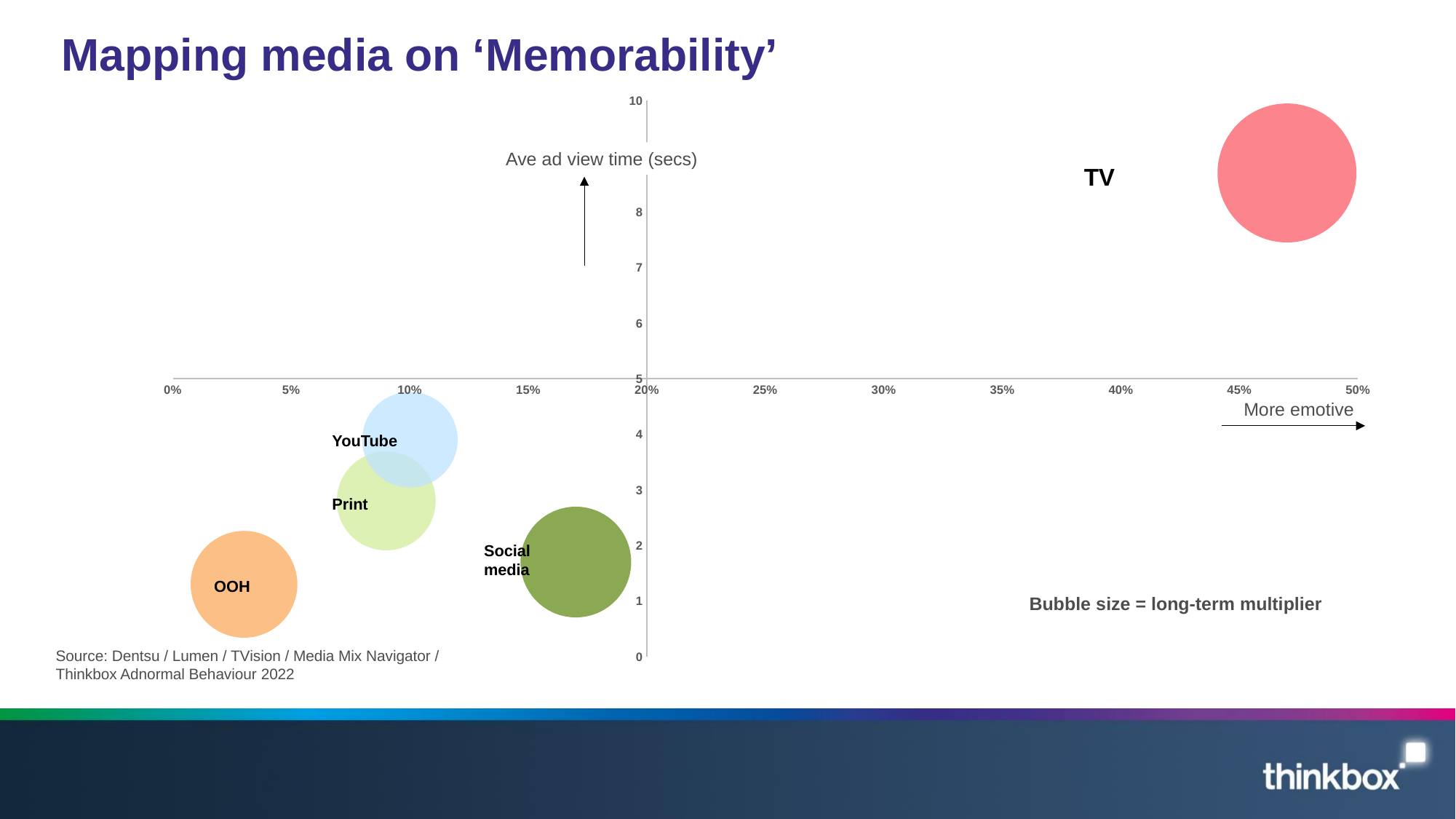
Is the emotive value for TV greater or less than 40%? greater According to the chart note, what does bubble size represent? Long-term multiplier Is the emotive value for OOH greater or less than 5%? less Which medium has the highest average ad view time? TV How many media bubbles are plotted on the chart? 5 Is the average ad view time for TV greater or less than 5 seconds? greater Which medium is plotted furthest to the left on the 'More emotive' axis? OOH Which has a higher average ad view time, YouTube or Print? YouTube What kind of chart is shown on the slide? Bubble chart Which medium has the largest bubble (long-term multiplier)? TV